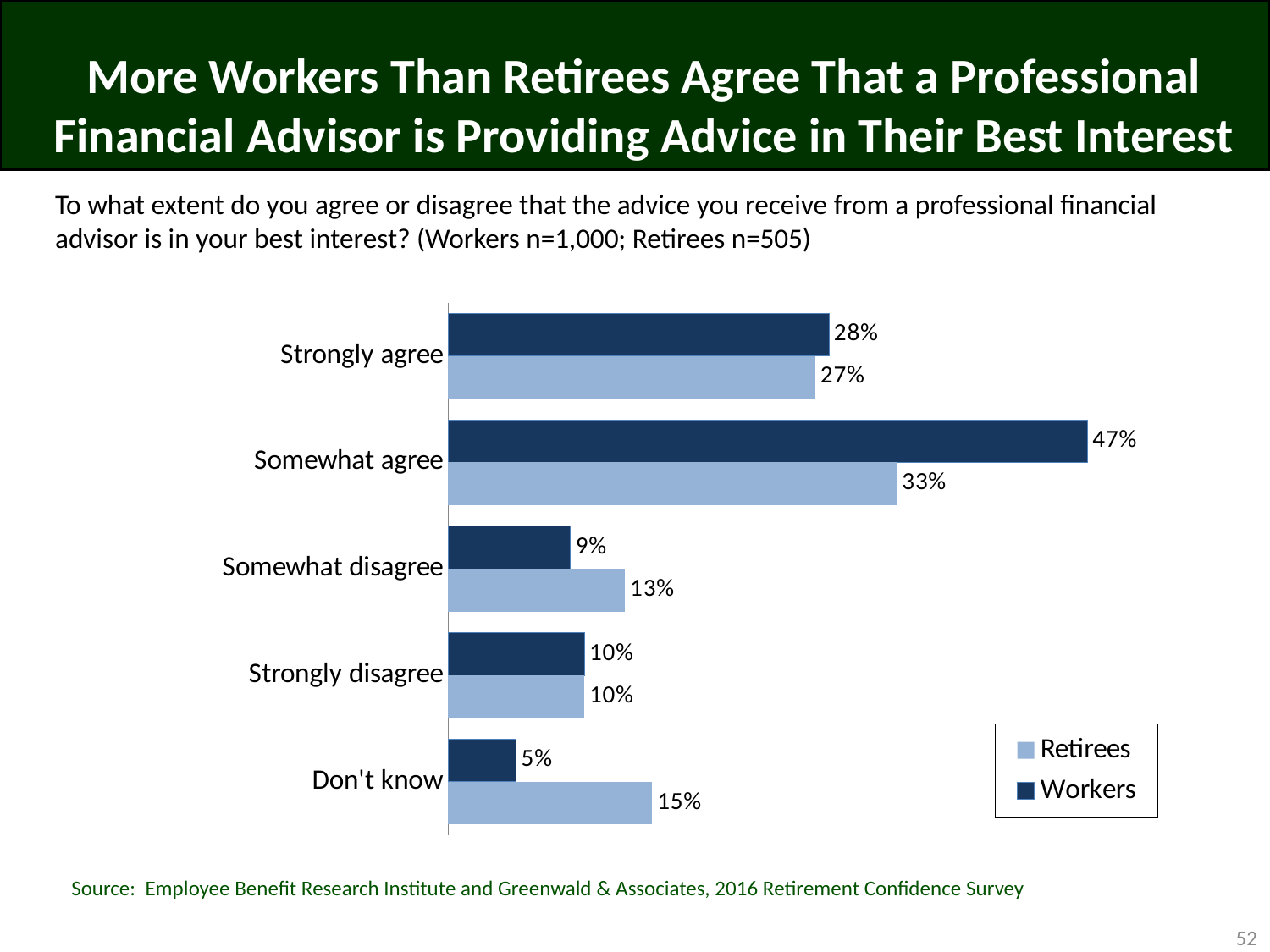
What percentage of Workers somewhat agree that the advice they receive is in their best interest? 47% What percentage of Retirees strongly agree? 27% For 'Somewhat disagree', which group has the larger value, Workers or Retirees? Retirees How many series does the legend list? 2 How many response categories are shown on the chart? 5 What is the difference between Retirees and Workers for 'Don't know'? 10 percentage points Which colour represents Workers in the chart? Dark blue Which response category has the lowest value for Workers? Don't know What percentage of Retirees answered 'Don't know'? 15% What kind of chart is shown on the slide? Bar chart What is the difference between Workers and Retirees for 'Somewhat agree'? 14 percentage points Which response category has the highest value for Workers? Somewhat agree